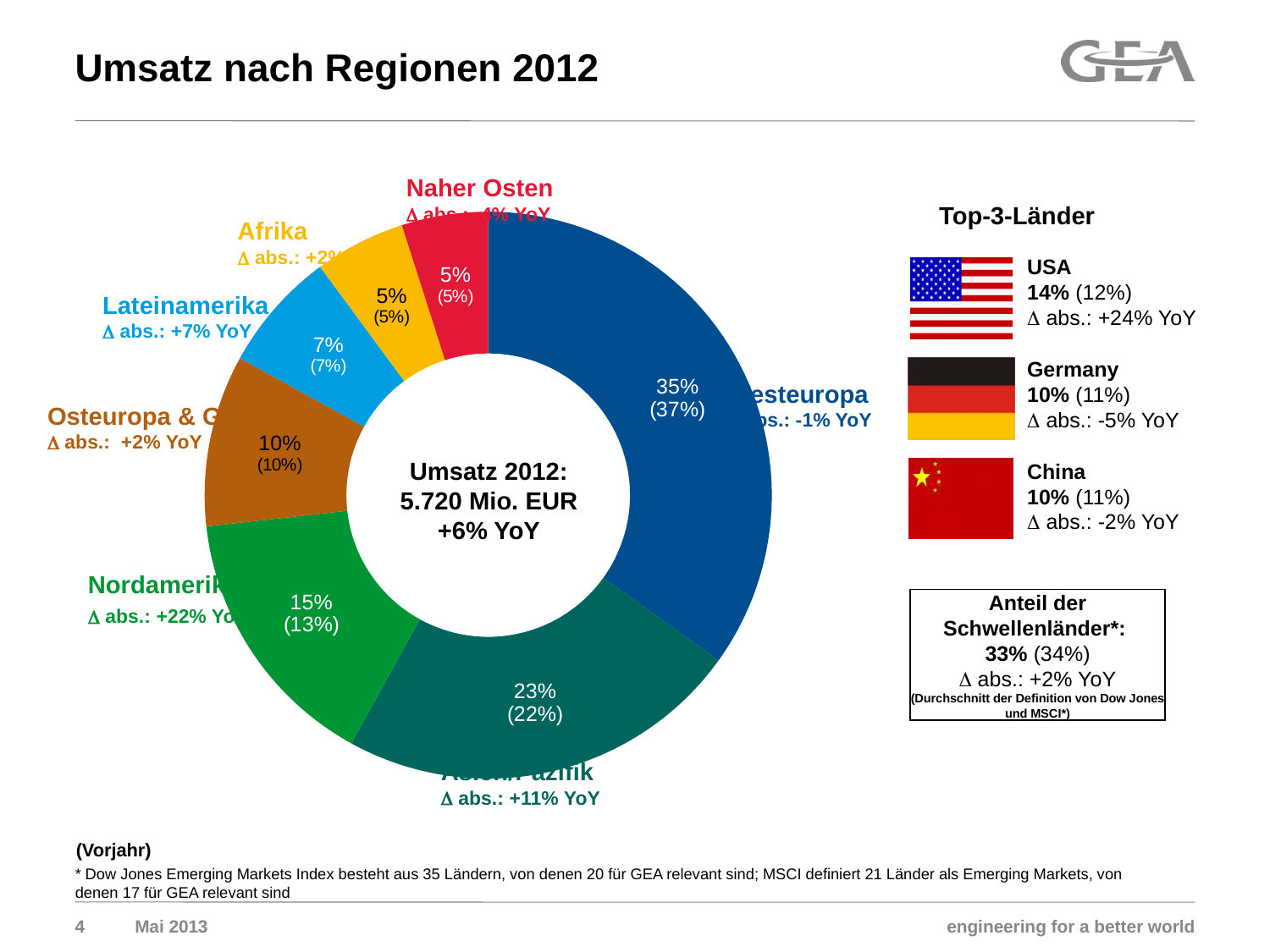
What absolute year-over-year change is shown for Lateinamerika? +7% YoY What is the smallest share shown in the pie chart? 5% What share of revenue does Afrika account for in 2012? 5% Which has the larger share, Lateinamerika or Osteuropa & GUS? Osteuropa & GUS What share of revenue does Lateinamerika account for in 2012? 7% How many percentage points larger is the Nordamerika share (15%) than the Lateinamerika share (7%)? 8 percentage points What kind of chart is used to show the revenue by region? pie chart (donut) How many segments does the pie chart have? 7 What is the largest share shown in the pie chart? 35% What was the prior-year share (in parentheses) for Nordamerika? 13% What share of revenue does Naher Osten account for in 2012? 5% What total revenue for 2012 is shown in the centre of the chart? 5.720 Mio. EUR